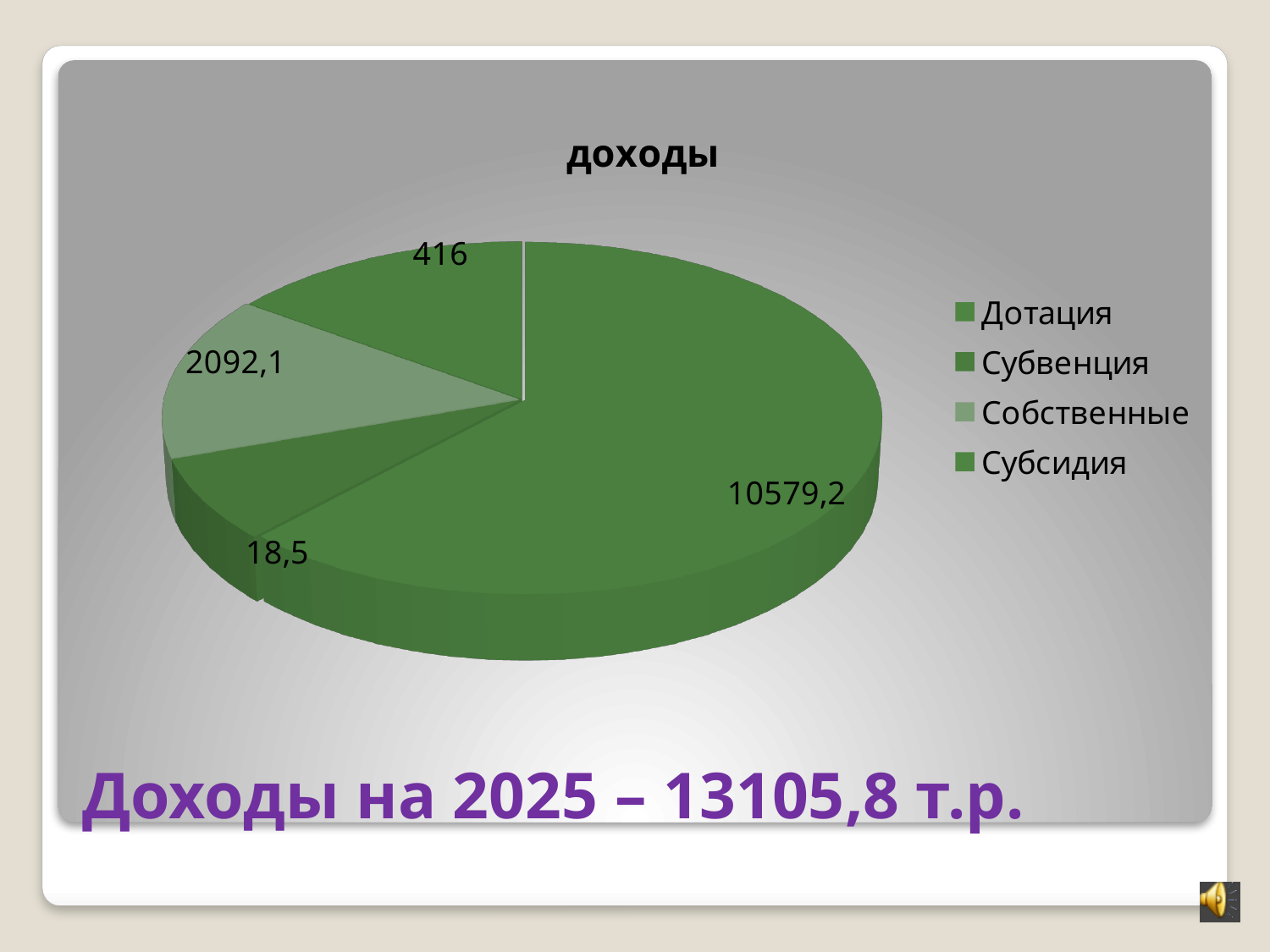
What is the value of the Дотация slice? 10579,2 What type of chart is shown on the slide? pie chart What is the title of the chart? доходы What is the value of the Субсидия slice? 416 What is the value of the Субвенция slice? 18,5 What is the value of the Собственные slice? 2092,1 Which category has the smallest slice of the pie? Субвенция What is the difference between the Дотация and Собственные values? 8487,1 Which is larger, the Собственные slice or the Субсидия slice? Собственные What is the total of all slices in the pie chart? 13105,8 Which category has the largest slice of the pie? Дотация How many categories does the legend of the pie chart list? 4